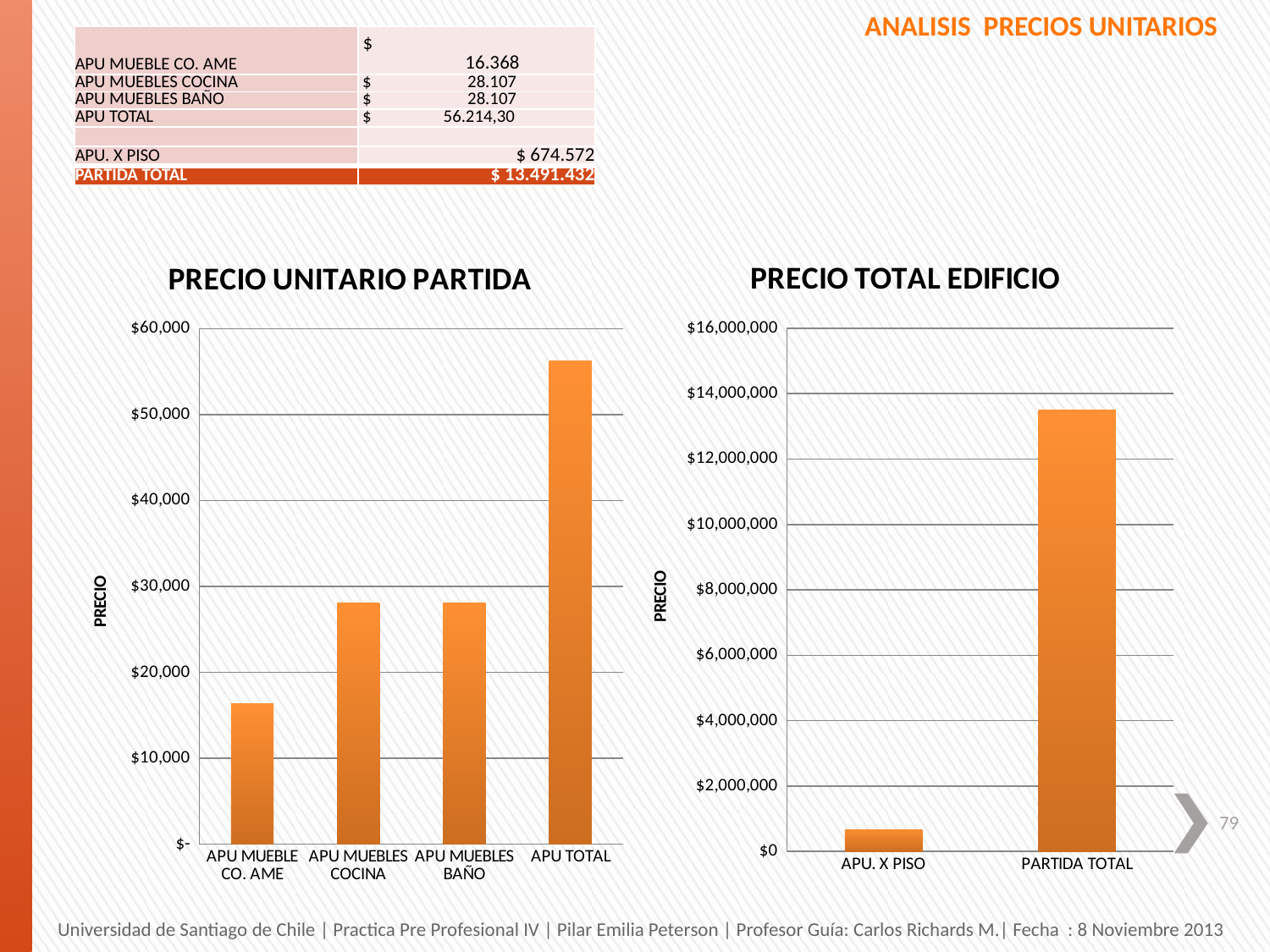
What is the y-axis label of the "PRECIO TOTAL EDIFICIO" chart? PRECIO In the "PRECIO UNITARIO PARTIDA" chart, which is larger, APU MUEBLES BAÑO or APU MUEBLE CO. AME? APU MUEBLES BAÑO What kind of chart is the "PRECIO UNITARIO PARTIDA" chart? bar chart In the "PRECIO TOTAL EDIFICIO" chart, which category has the higher bar? PARTIDA TOTAL How many categories are shown on the x axis of the "PRECIO TOTAL EDIFICIO" chart? 2 In the "PRECIO UNITARIO PARTIDA" chart, is the value for APU MUEBLES COCINA greater or less than $30,000? less In the "PRECIO UNITARIO PARTIDA" chart, is the value for APU MUEBLE CO. AME greater or less than $20,000? less In the "PRECIO UNITARIO PARTIDA" chart, which category has the lowest bar? APU MUEBLE CO. AME In the "PRECIO TOTAL EDIFICIO" chart, is the value for PARTIDA TOTAL greater or less than $14,000,000? less In the "PRECIO UNITARIO PARTIDA" chart, which category has the highest bar? APU TOTAL How many categories are shown on the x axis of the "PRECIO UNITARIO PARTIDA" chart? 4